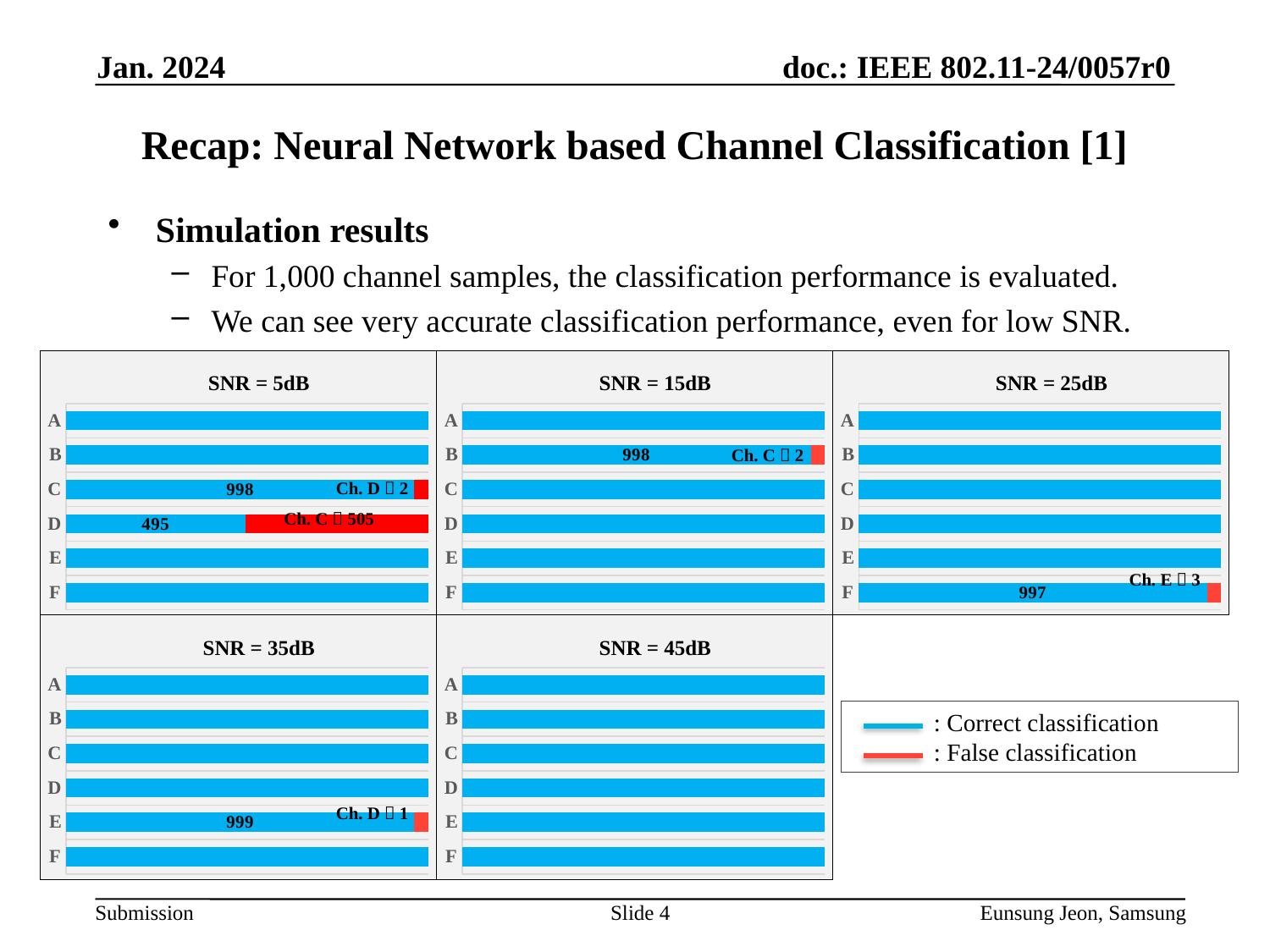
In the SNR = 5dB chart, how many channel D samples were falsely classified as Ch. C? 505 How many entries does the legend list for the classification charts? 2 In the SNR = 5dB chart, which is larger for channel D: the correct classifications (495) or the false classifications as Ch. C (505)? False classifications as Ch. C (505) In the SNR = 5dB chart, what is the number of correct classifications for channel D? 495 In the SNR = 35dB chart, what is the number of correct classifications for channel E? 999 How many channel categories are shown in the SNR = 45dB chart? 6 In the SNR = 5dB chart, what is the number of correct classifications for channel C? 998 What kind of chart is used for the SNR = 5dB panel? Stacked horizontal bar chart In the SNR = 5dB chart, what is the total of the stacked bar for channel D (correct plus false)? 1000 In the SNR = 25dB chart, how many channel F samples were falsely classified as Ch. E? 3 In the SNR = 15dB chart, what is the number of correct classifications for channel B? 998 In the SNR = 25dB chart, what is the difference between the correct classifications for channel F (997) and the false classifications as Ch. E (3)? 994